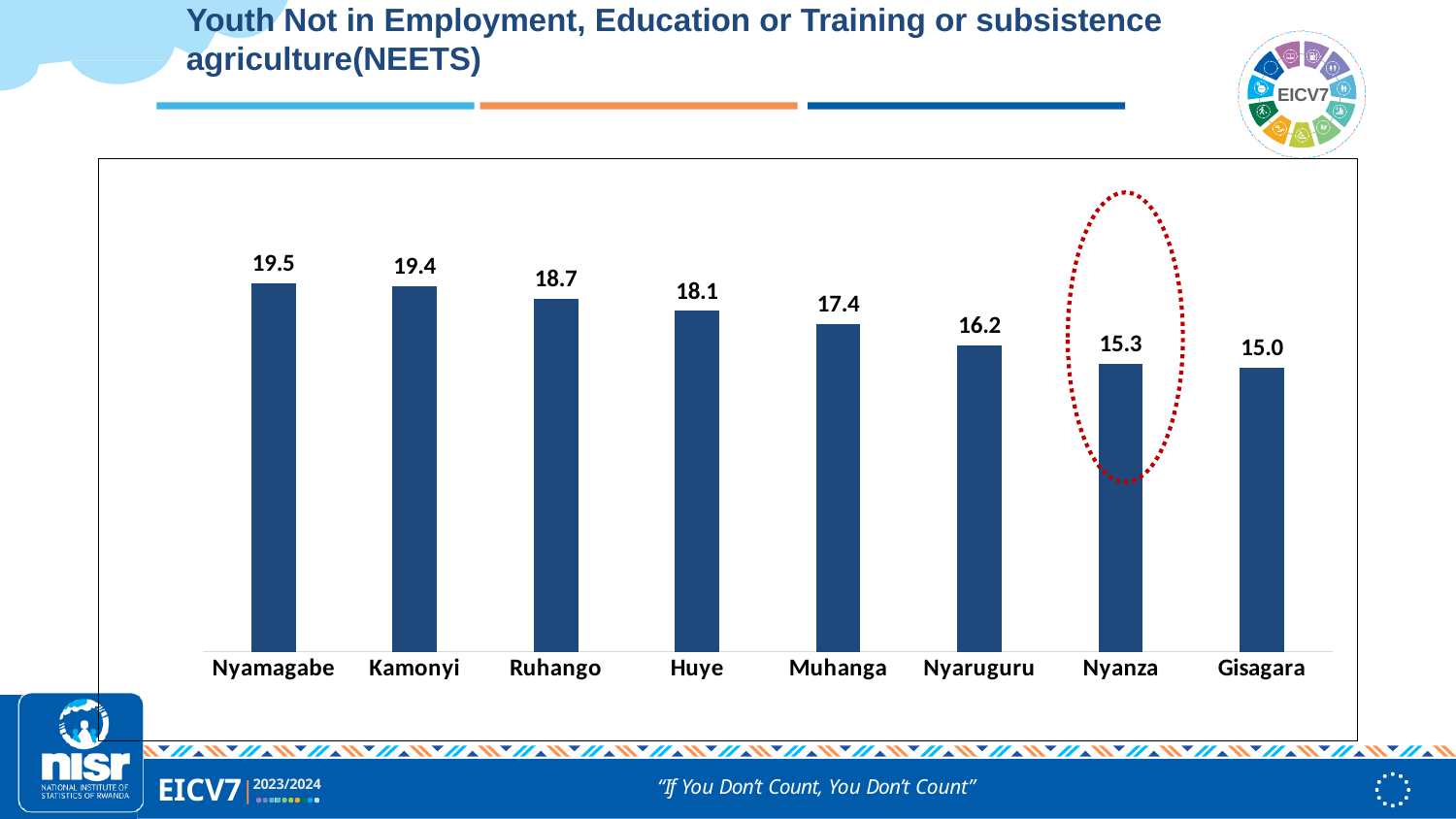
What is the value for Nyanza? 15.3 How many districts are shown on the chart? 8 Which district's bar is circled with a red dotted outline? Nyanza What is the difference between the values for Nyamagabe and Gisagara? 4.5 What kind of chart is shown on the slide? bar chart Which is larger, the value for Huye or the value for Nyaruguru? Huye Which district has the highest value? Nyamagabe What is the difference between the values for Ruhango and Nyaruguru? 2.5 What is the value for Muhanga? 17.4 Do the values rise or fall from left to right along the x axis? fall What is the value for Nyamagabe? 19.5 Which district has the lowest value? Gisagara